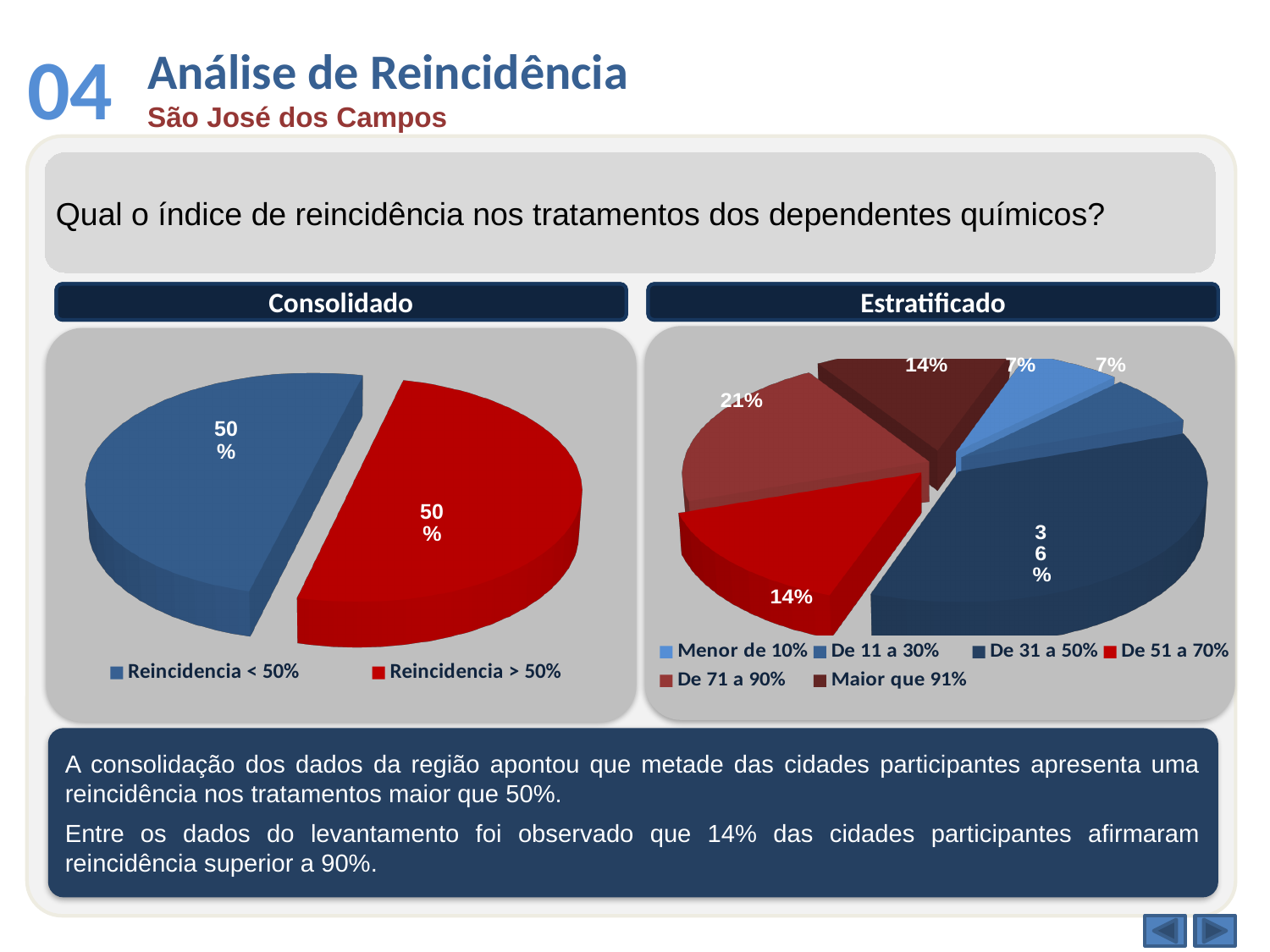
What colour is the 'Reincidencia > 50%' slice in the 'Consolidado' chart? red How many slices does the 'Consolidado' chart have? 2 In the 'Estratificado' chart, what is the value for 'Maior que 91%'? 14% What kind of chart is the 'Consolidado' chart? pie chart In the 'Estratificado' chart, what is the difference between the values for 'De 31 a 50%' and 'De 71 a 90%'? 15% In the 'Estratificado' chart, what is the value for 'De 31 a 50%'? 36% In the 'Consolidado' chart, what is the value for 'Reincidencia < 50%'? 50% In the 'Estratificado' chart, which category has the largest share? De 31 a 50% In the 'Estratificado' chart, what is the value for 'De 71 a 90%'? 21% In the 'Consolidado' chart, what is the value for 'Reincidencia > 50%'? 50% How many categories does the legend of the 'Estratificado' chart list? 6 In the 'Estratificado' chart, which is larger: 'De 51 a 70%' or 'De 71 a 90%'? De 71 a 90%